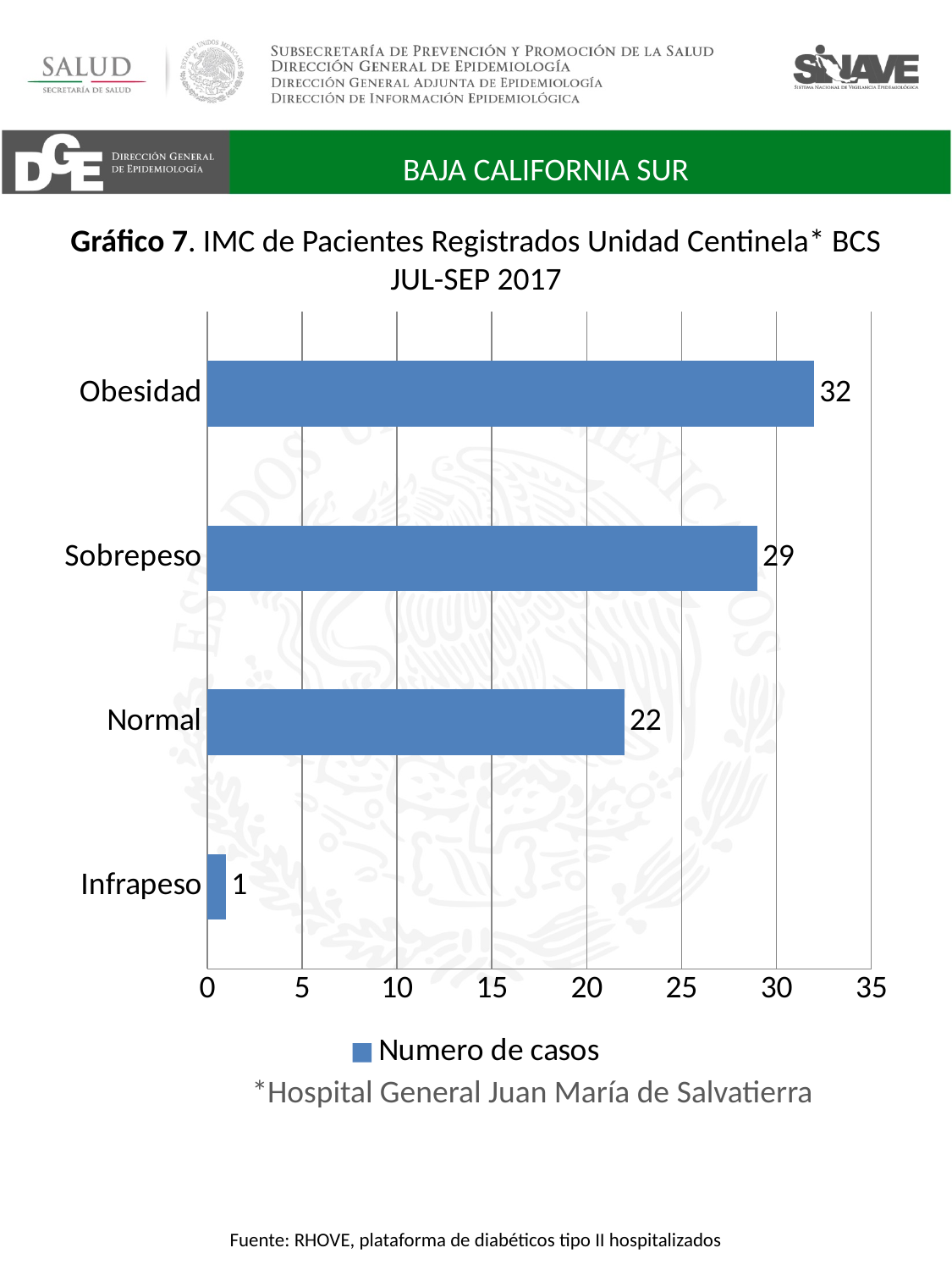
Which category has the highest number of cases? Obesidad What is the number of cases for Sobrepeso? 29 What is the difference in number of cases between Obesidad and Sobrepeso? 3 Which has more cases, Sobrepeso or Normal? Sobrepeso What is the number of cases for Normal? 22 What is the difference in number of cases between Normal and Infrapeso? 21 What is the number of cases for Obesidad? 32 What is the number of cases for Infrapeso? 1 What series name does the legend show? Numero de casos How many categories are shown in the chart? 4 Which category has the lowest number of cases? Infrapeso What kind of chart is shown on the slide? Bar chart